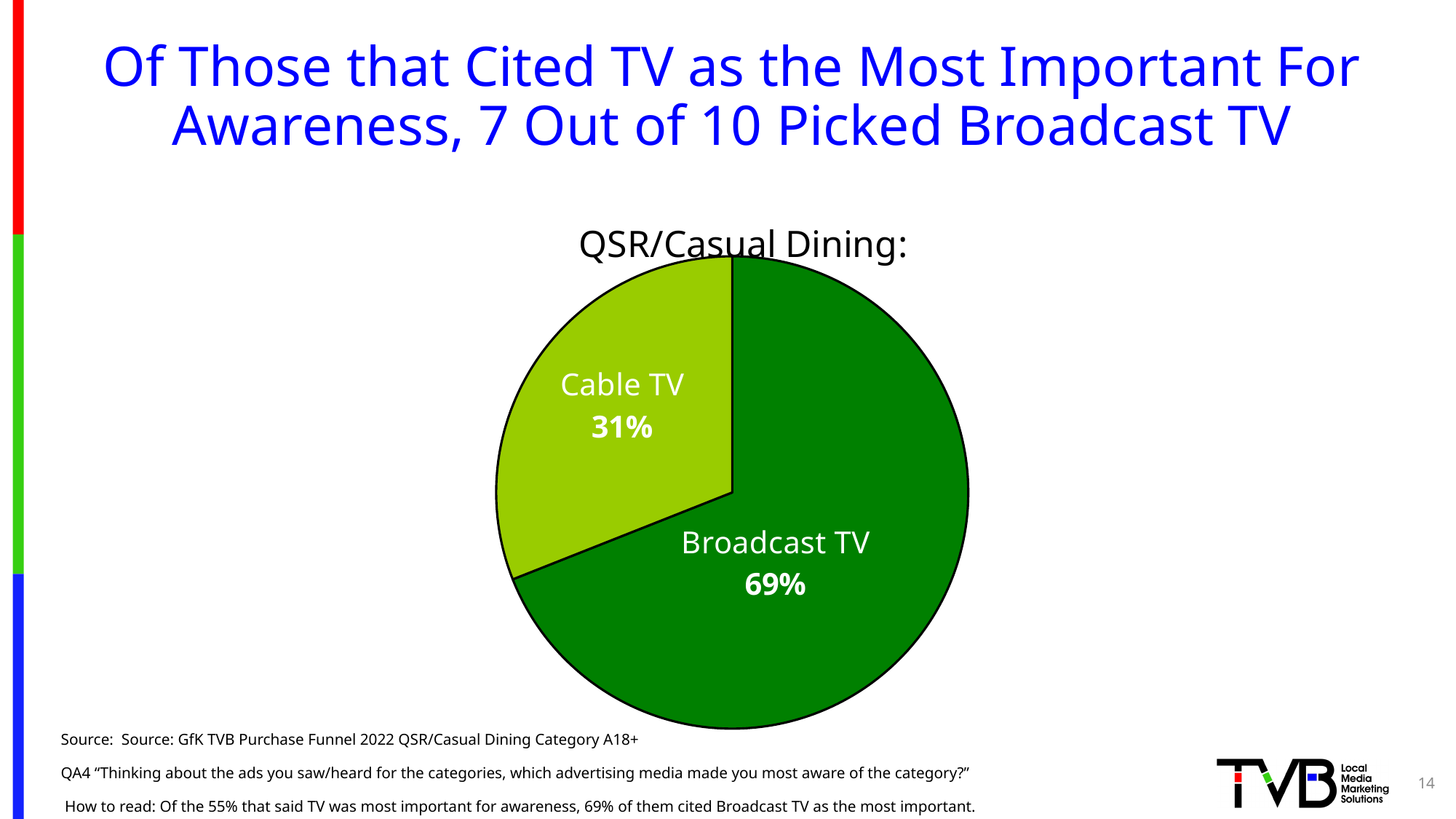
What is the title of the pie chart? QSR/Casual Dining: Which is larger, the Cable TV slice or the Broadcast TV slice? Broadcast TV Which slice of the pie is the smallest? Cable TV How many slices does the pie chart have? 2 What is the difference in percentage points between Broadcast TV and Cable TV? 38 Which slice of the pie is the largest? Broadcast TV What share of the pie does Broadcast TV have? 69% What colour is the Cable TV slice? Light green What kind of chart is shown on the slide? Pie chart What share of the pie does Cable TV have? 31% What is the total of the two slices shown in the pie chart? 100%